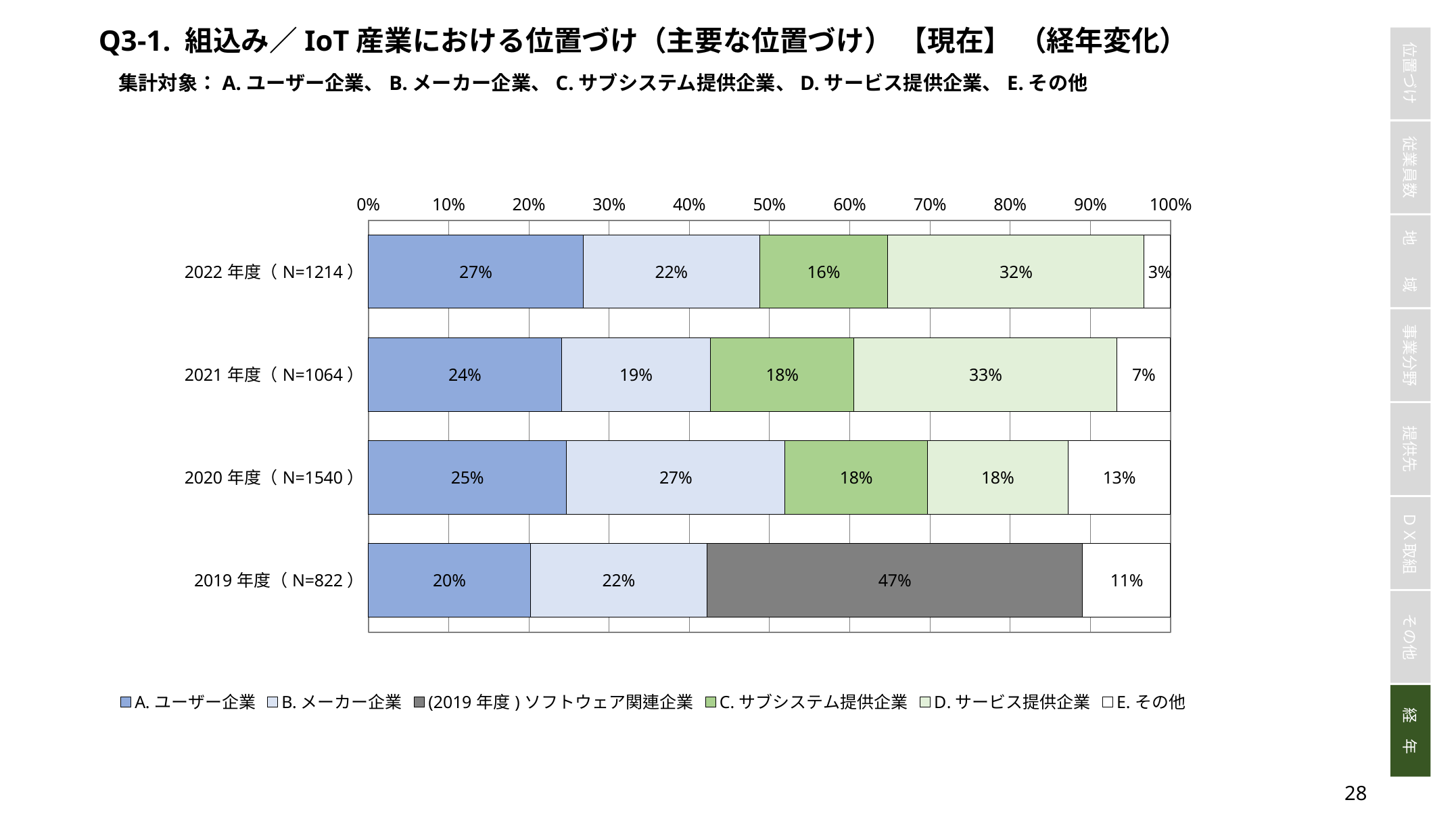
What kind of chart is shown on the slide? Stacked bar chart What is the value for D. サービス提供企業 in 2021年度 (N=1064)? 33% How many series does the legend list? 6 How many year categories are shown on the chart? 4 What is the N value shown for 2020年度? N=1540 What share of 2019年度 (N=822) respondents were (2019年度) ソフトウェア関連企業? 47% What is the difference between the D. サービス提供企業 values for 2021年度 and 2020年度? 15 percentage points What is the value for E. その他 in 2020年度 (N=1540)? 13% Which year has the highest value for A. ユーザー企業? 2022年度 (N=1214) Which is larger: B. メーカー企業 in 2020年度 or B. メーカー企業 in 2021年度? 2020年度 Which year has the lowest value for E. その他? 2022年度 (N=1214) What percentage of respondents in 2022年度 (N=1214) were A. ユーザー企業? 27%